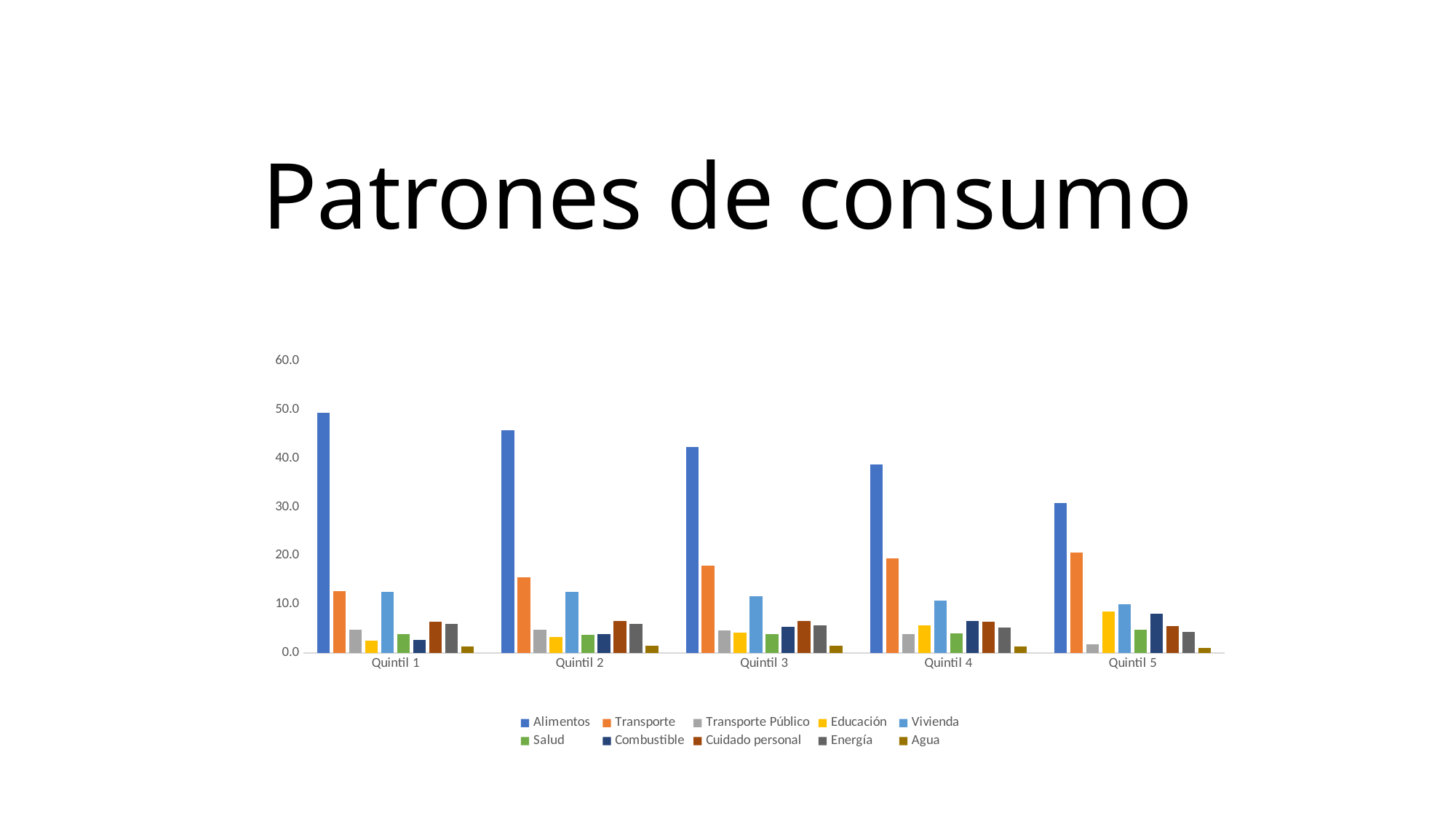
Is the value for Transporte in Quintil 1 greater or less than 20.0? less Which quintil has the highest value for Alimentos? Quintil 1 Is the value for Alimentos in Quintil 1 greater or less than 40.0? greater In Quintil 5, which is larger: Transporte or Vivienda? Transporte How many quintil categories are shown on the x axis? 5 Do the Alimentos values rise or fall from Quintil 1 to Quintil 5? fall What is the title of the slide containing the chart? Patrones de consumo Do the Transporte values rise or fall from Quintil 1 to Quintil 5? rise What kind of chart is shown on the slide? bar chart Which quintil has the lowest value for Alimentos? Quintil 5 How many series does the legend list? 10 Is the value for Alimentos in Quintil 5 greater or less than 40.0? less